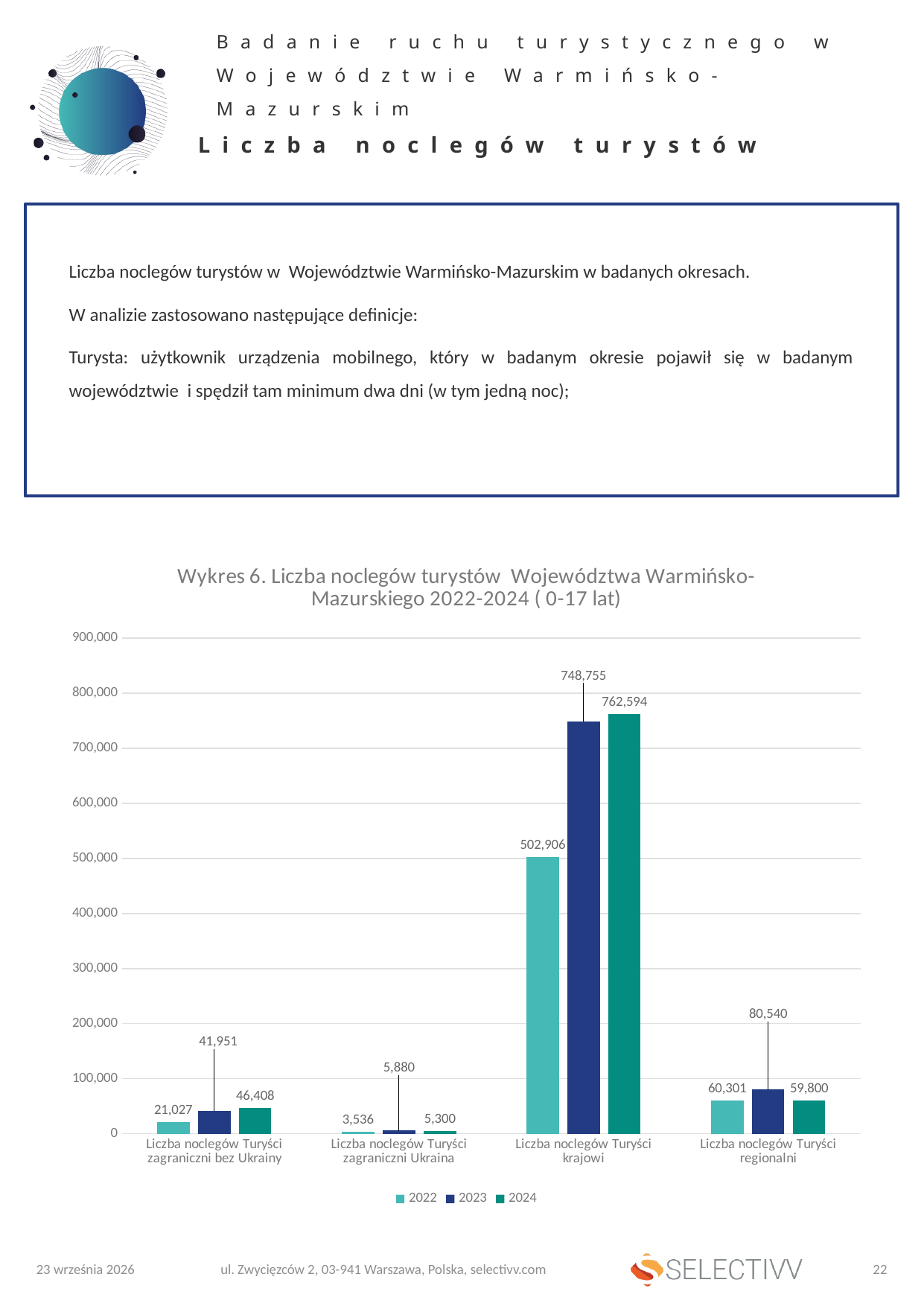
What is the value for 2023 in the category 'Liczba noclegów Turyści zagraniczni Ukraina'? 5,880 Is the 2022 value for 'Liczba noclegów Turyści krajowi' greater or less than 600,000? less What is the value for 2023 in the category 'Liczba noclegów Turyści krajowi'? 748,755 How many series does the legend list? 3 What kind of chart is shown on the slide? bar chart Which is larger in the category 'Liczba noclegów Turyści regionalni': the 2022 value or the 2024 value? 2022 Which category has the highest value for 2024? Liczba noclegów Turyści krajowi Which category has the lowest value for 2022? Liczba noclegów Turyści zagraniczni Ukraina How many categories are shown on the x axis of the chart? 4 What is the difference between the 2024 and 2023 values for 'Liczba noclegów Turyści krajowi'? 13,839 What is the value for 2022 in the category 'Liczba noclegów Turyści zagraniczni bez Ukrainy'? 21,027 What is the value for 2024 in the category 'Liczba noclegów Turyści regionalni'? 59,800